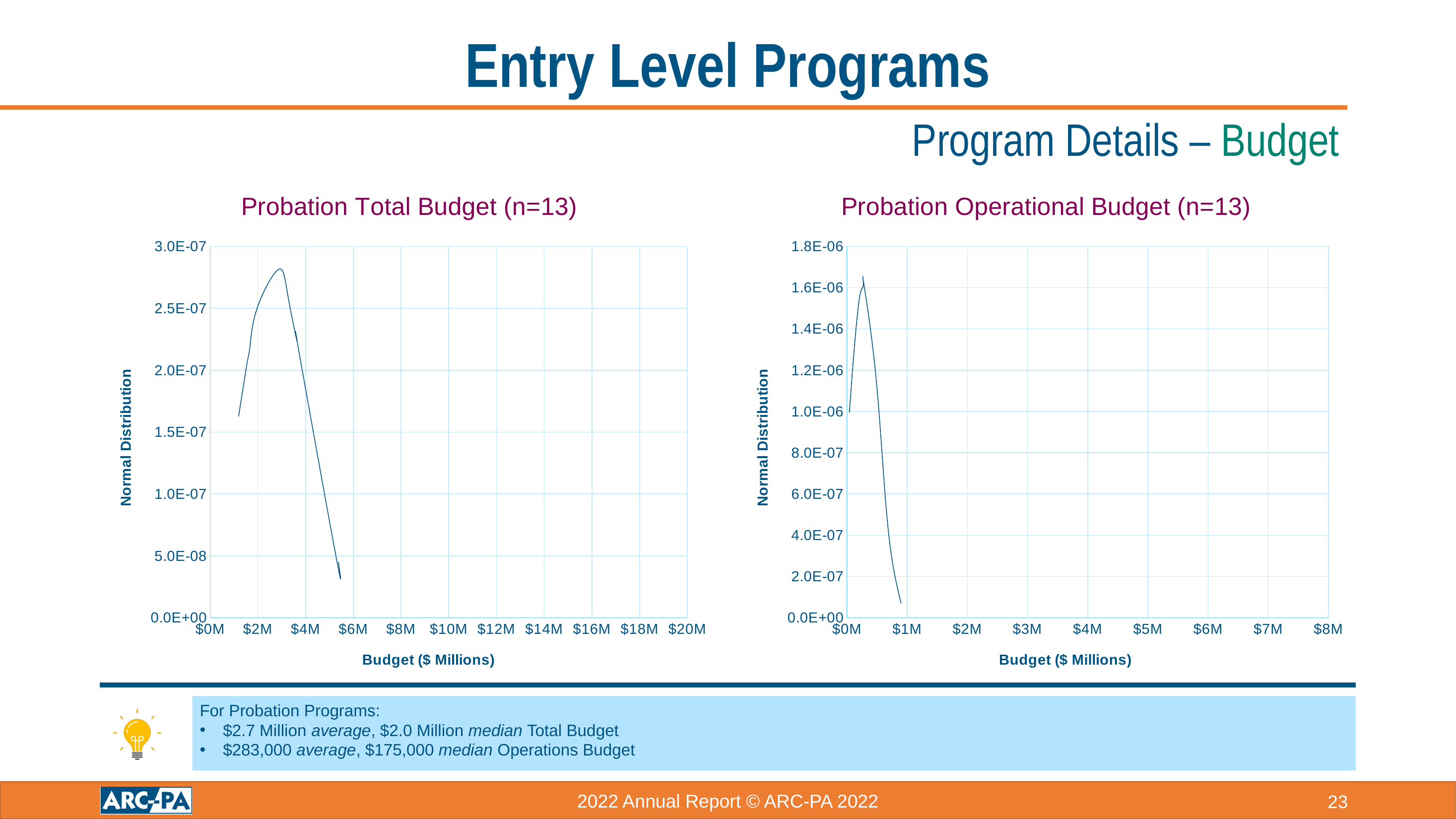
In the Probation Total Budget (n=13) chart, does the curve rise or fall between $4M and $6M? fall In the Probation Operational Budget (n=13) chart, is the peak of the curve greater or less than 1.4E-06? greater In the Probation Operational Budget (n=13) chart, is the lowest point of the curve greater or less than 2.0E-07? less In the Probation Total Budget (n=13) chart, is the peak of the curve greater or less than 2.5E-07? greater What kind of chart is the Probation Total Budget (n=13) chart? line chart How many charts are shown on the slide? 2 In the Probation Operational Budget (n=13) chart, does the curve rise or fall after its peak as the budget increases? fall What is the y-axis label of the Probation Total Budget (n=13) chart? Normal Distribution Which chart has the higher peak value on its y axis, Probation Total Budget (n=13) or Probation Operational Budget (n=13)? Probation Operational Budget (n=13) What is the title of the chart on the right of the slide? Probation Operational Budget (n=13)